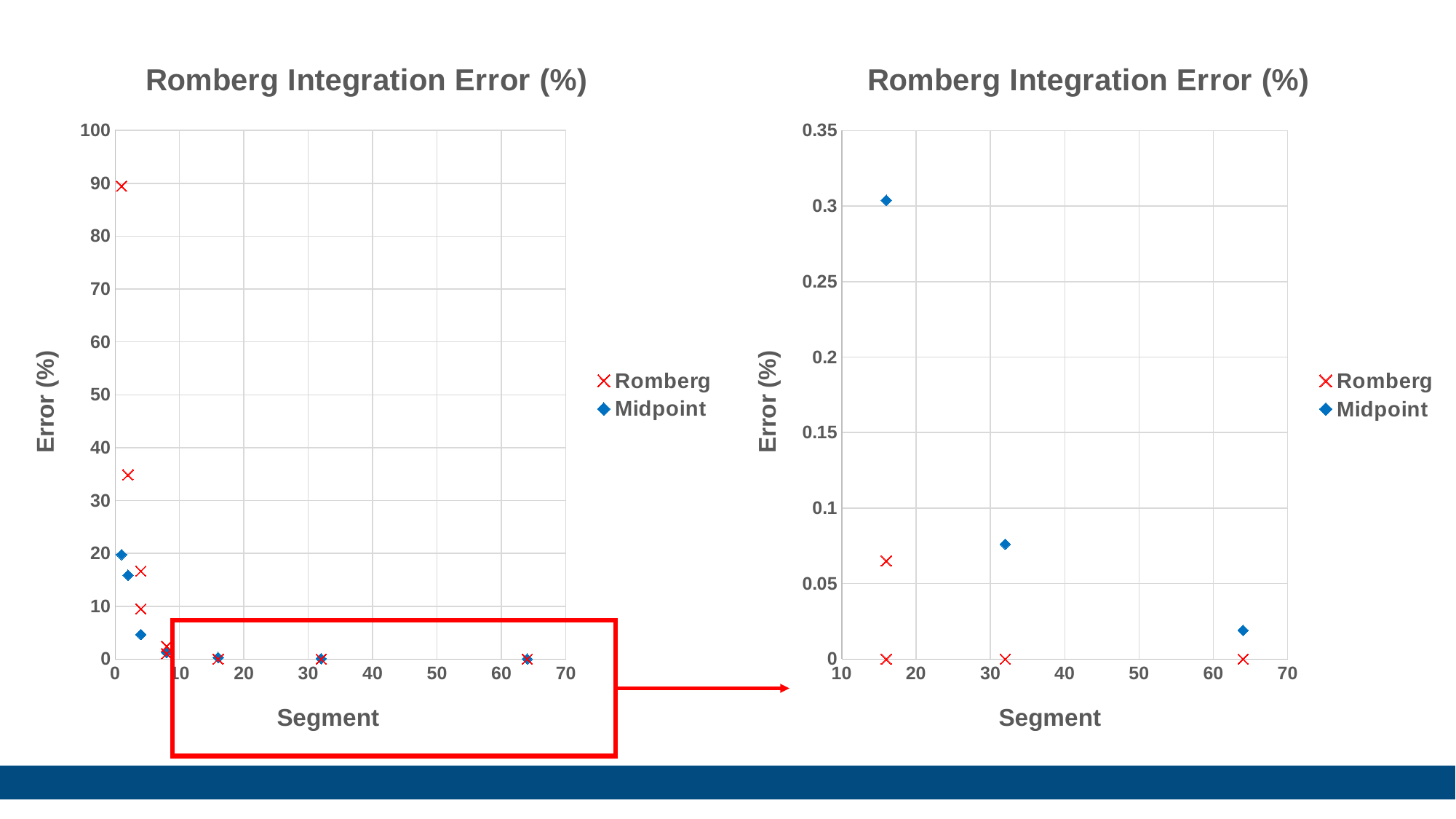
In the left chart, what are the two series named in the legend? Romberg and Midpoint In the right chart, is the Midpoint error at segment 16 greater or less than 0.25? greater In the left chart, what is the label of the x axis? Segment What kind of chart is the left chart titled 'Romberg Integration Error (%)'? scatter chart In the left chart, is the leftmost Midpoint error value greater or less than 10? greater In the right chart, how many Midpoint data points are plotted? 3 In the left chart, at the smallest segment value, which series has the higher error: Romberg or Midpoint? Romberg In the right chart, at which segment value is the Midpoint error highest? 16 In the right chart, is the Midpoint error at segment 64 greater or less than 0.05? less In the right chart, how many series does the legend list? 2 In the left chart, does the Midpoint error rise or fall as the segment count increases? fall